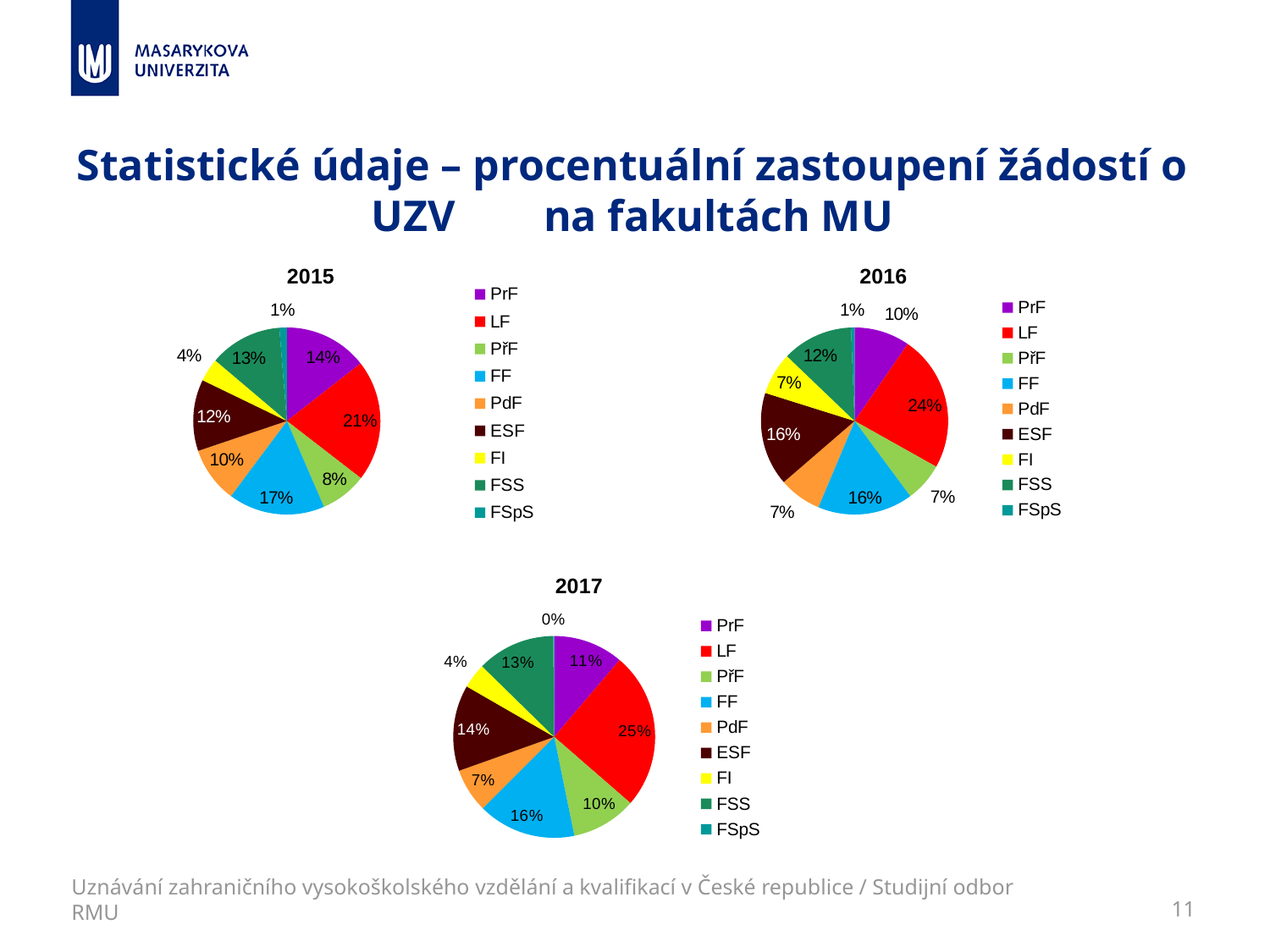
In the 2017 chart, which faculty has the largest share? LF In the 2015 chart, which is larger, the share for FF or the share for FSS? FF In the 2017 chart, what is the combined share of FF and PdF? 23% In the 2015 chart, what share of applications does LF have? 21% In the 2015 chart, which faculty has the smallest share? FSpS In the 2016 chart, what is the value for ESF? 16% What type of chart is used for the 2015 data? Pie chart How many entries does the legend of the 2017 chart list? 9 In the 2016 chart, what is the difference between the LF share and the PrF share? 14% How many slices does the 2016 pie chart have? 9 In the 2017 chart, what is the value for PřF? 10% What is the title of the chart in the bottom centre of the slide? 2017